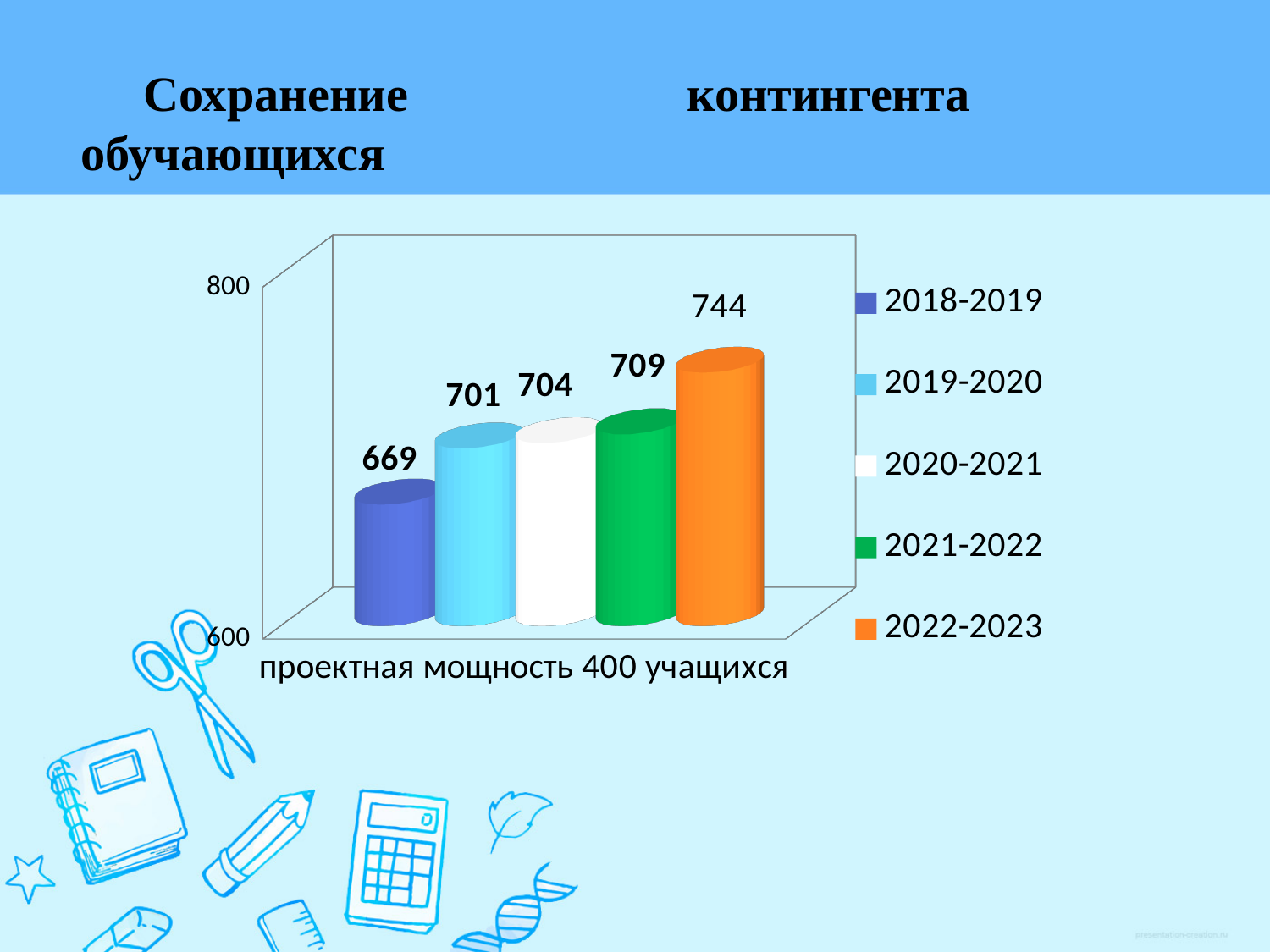
What is the value for 2020-2021? 704 What is the value for 2022-2023? 744 Do the values rise or fall from 2018-2019 to 2022-2023? rise Which year has the highest value? 2022-2023 What is the difference between the values for 2021-2022 and 2019-2020? 8 Which year has the lowest value? 2018-2019 Which is larger, the value for 2019-2020 or the value for 2022-2023? 2022-2023 What is the difference between the values for 2022-2023 and 2018-2019? 75 What is the value for 2018-2019? 669 How many entries does the legend list? 5 What kind of chart is shown on the slide? bar chart How many bars are shown in the chart? 5